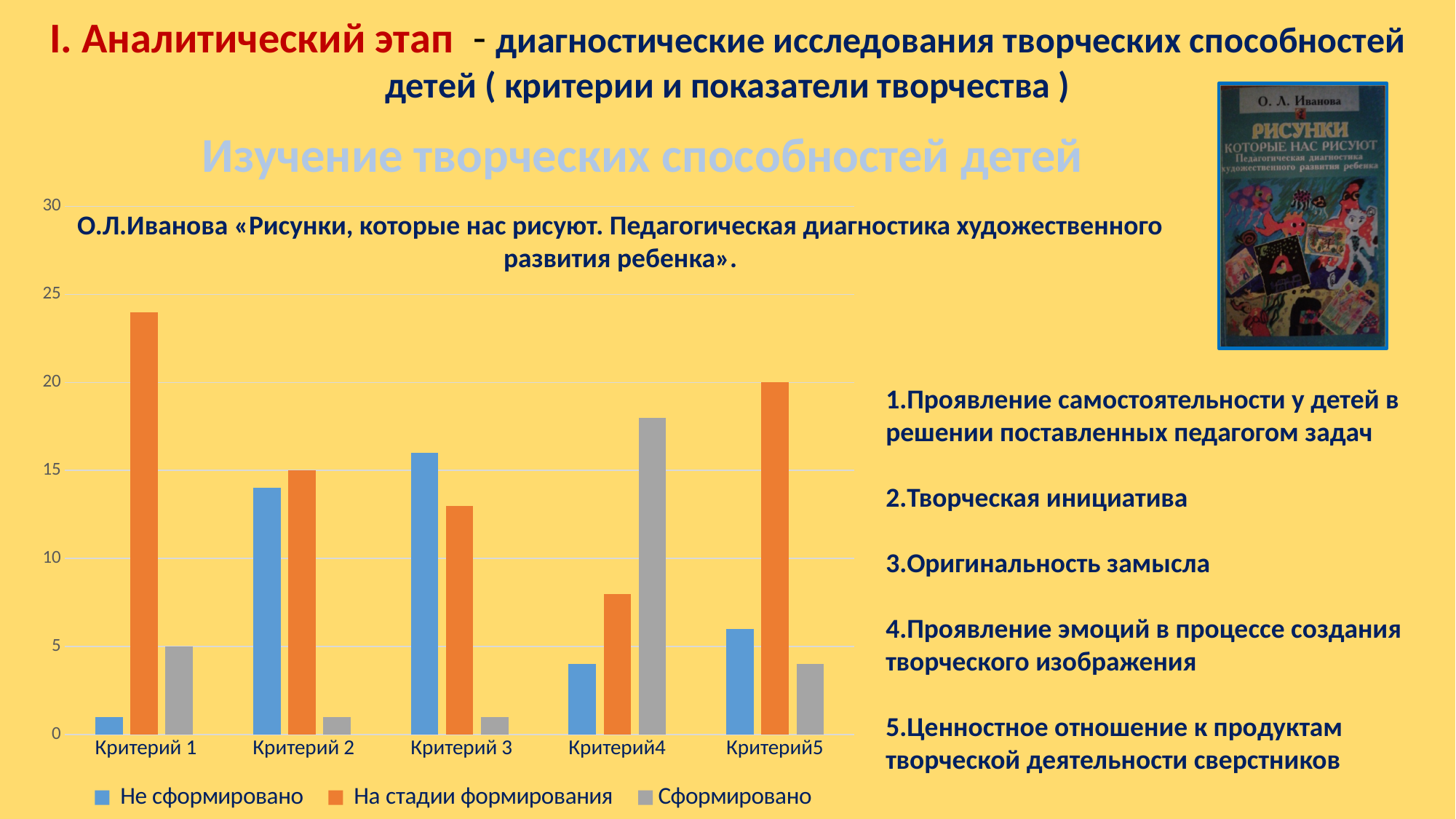
How many categories (criteria) are shown on the x axis of the chart? 5 Is the value for 'Не сформировано' in Критерий5 greater or less than 10? less What kind of chart is shown on the slide? bar chart How many series does the chart legend list? 3 Which category has the highest value for the series 'На стадии формирования'? Критерий 1 Is the value for 'На стадии формирования' in Критерий 1 greater or less than 20? greater In Критерий 3, which is larger: 'Не сформировано' or 'На стадии формирования'? Не сформировано Which category has the lowest value for the series 'Не сформировано'? Критерий 1 In Критерий4, which is larger: 'Сформировано' or 'На стадии формирования'? Сформировано What is the title of the chart? Изучение творческих способностей детей Which category has the highest value for the series 'Сформировано'? Критерий4 Is the value for 'Сформировано' in Критерий4 greater or less than 15? greater